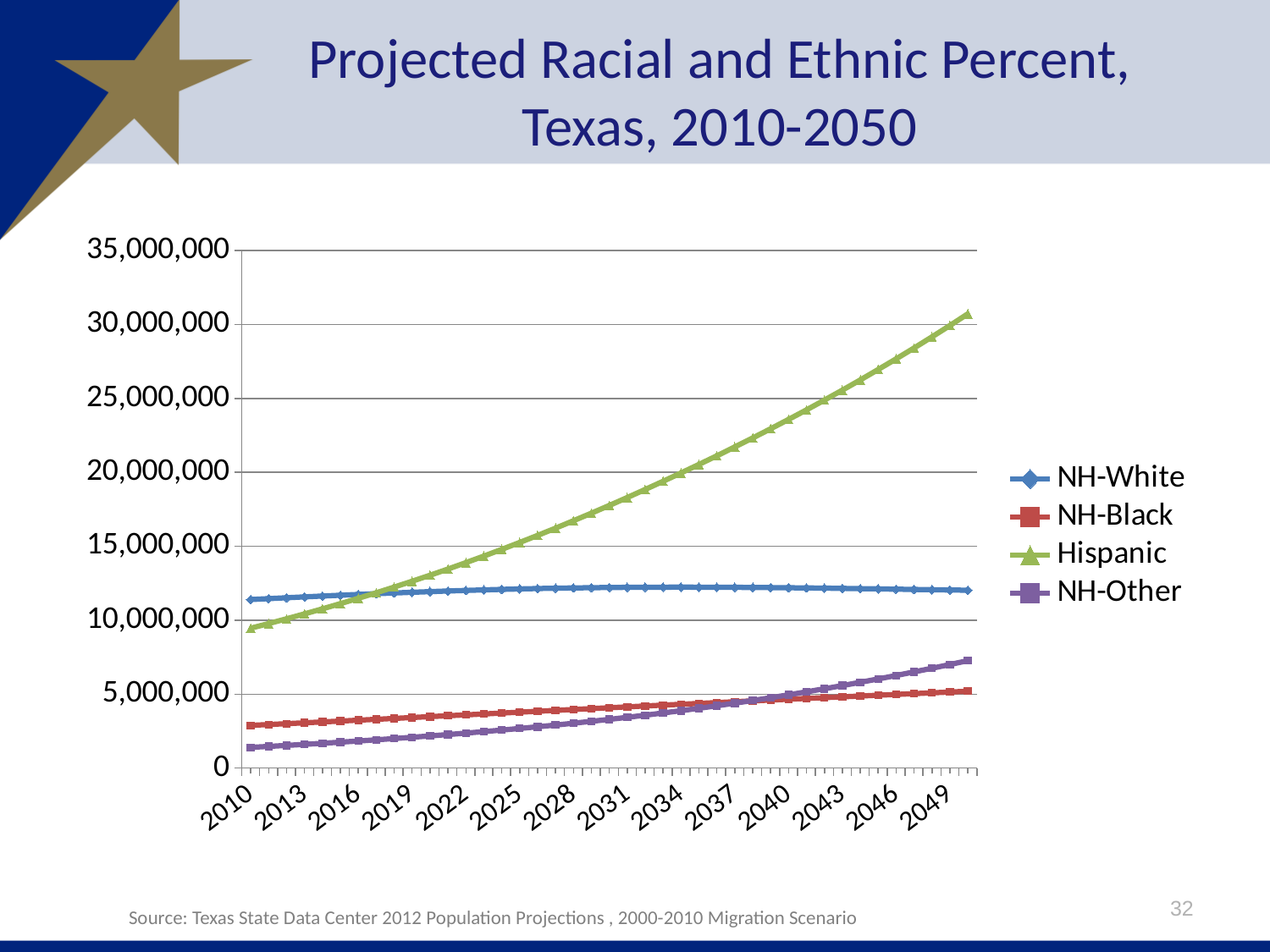
Does the NH-Other series rise or fall from 2010 to 2049? Rise How many series does the legend list? 4 Is the value for NH-Black in 2010 greater or less than 5,000,000? less Is the value for Hispanic in 2046 greater or less than 25,000,000? greater In 2010, which is larger: NH-White or Hispanic? NH-White Which series has the highest value in 2049? Hispanic Is the value for NH-White in 2010 greater or less than 10,000,000? greater What is the title of the chart? Projected Racial and Ethnic Percent, Texas, 2010-2050 Does the Hispanic series rise or fall from 2010 to 2049? Rise Which series is represented by the green line with triangle markers? Hispanic Which series has the lowest value in 2010? NH-Other What kind of chart is shown on the slide? Line chart